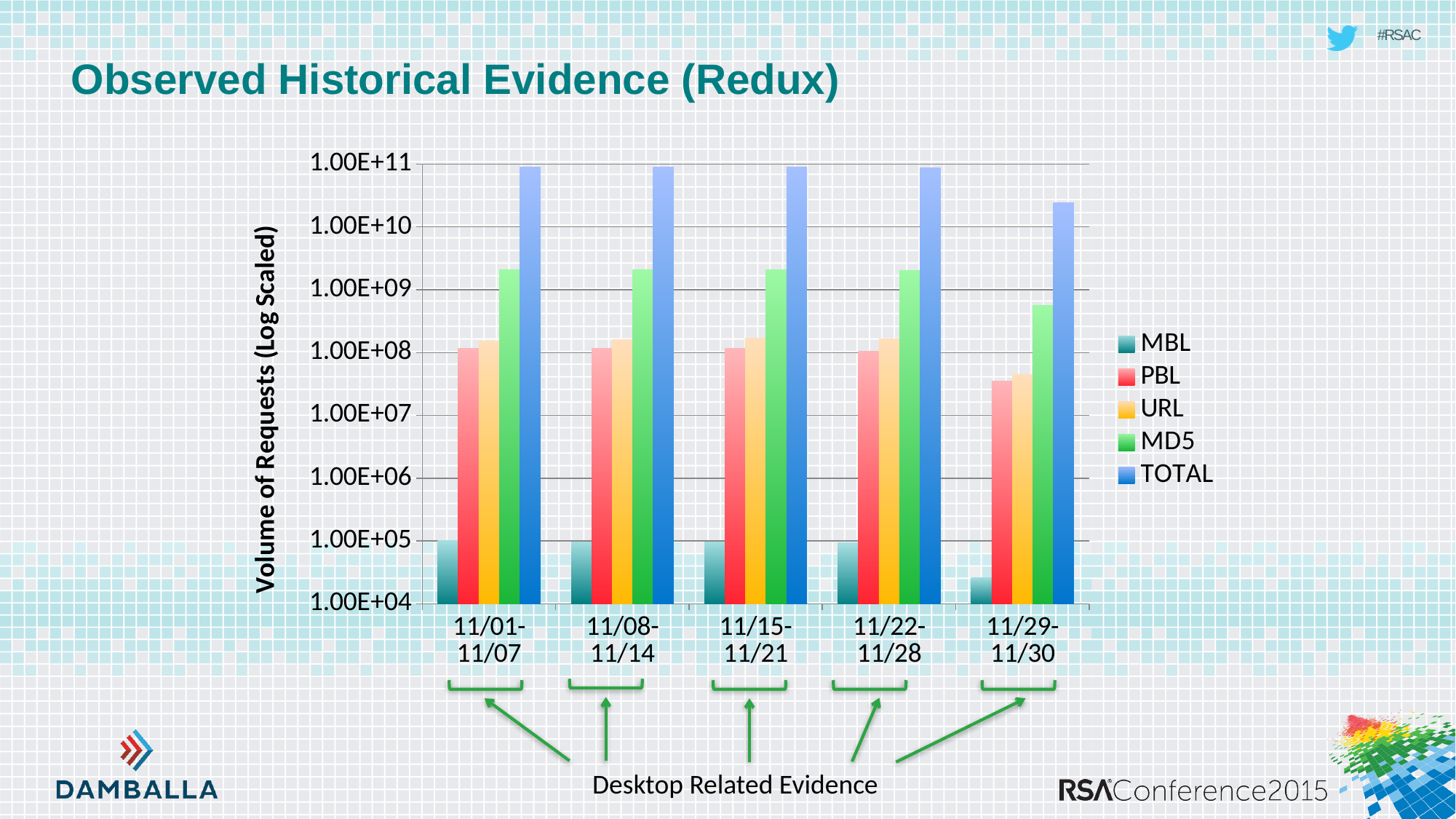
Does the TOTAL value rise or fall from the 11/22-11/28 period to the 11/29-11/30 period? fall How many series does the legend list? 5 Which series has the lowest value in the 11/29-11/30 period? MBL Is the TOTAL value for 11/01-11/07 greater or less than 1.00E+10? greater What is the title of the y axis? Volume of Requests (Log Scaled) Is the MBL value for 11/29-11/30 greater or less than 1.00E+05? less How many date ranges (categories) are shown on the x axis? 5 What kind of chart is shown on the slide? Bar chart Which series has the highest value in the 11/01-11/07 period? TOTAL In the 11/22-11/28 period, which is larger, the MD5 value or the PBL value? MD5 Is the MD5 value for 11/15-11/21 greater or less than 1.00E+09? greater